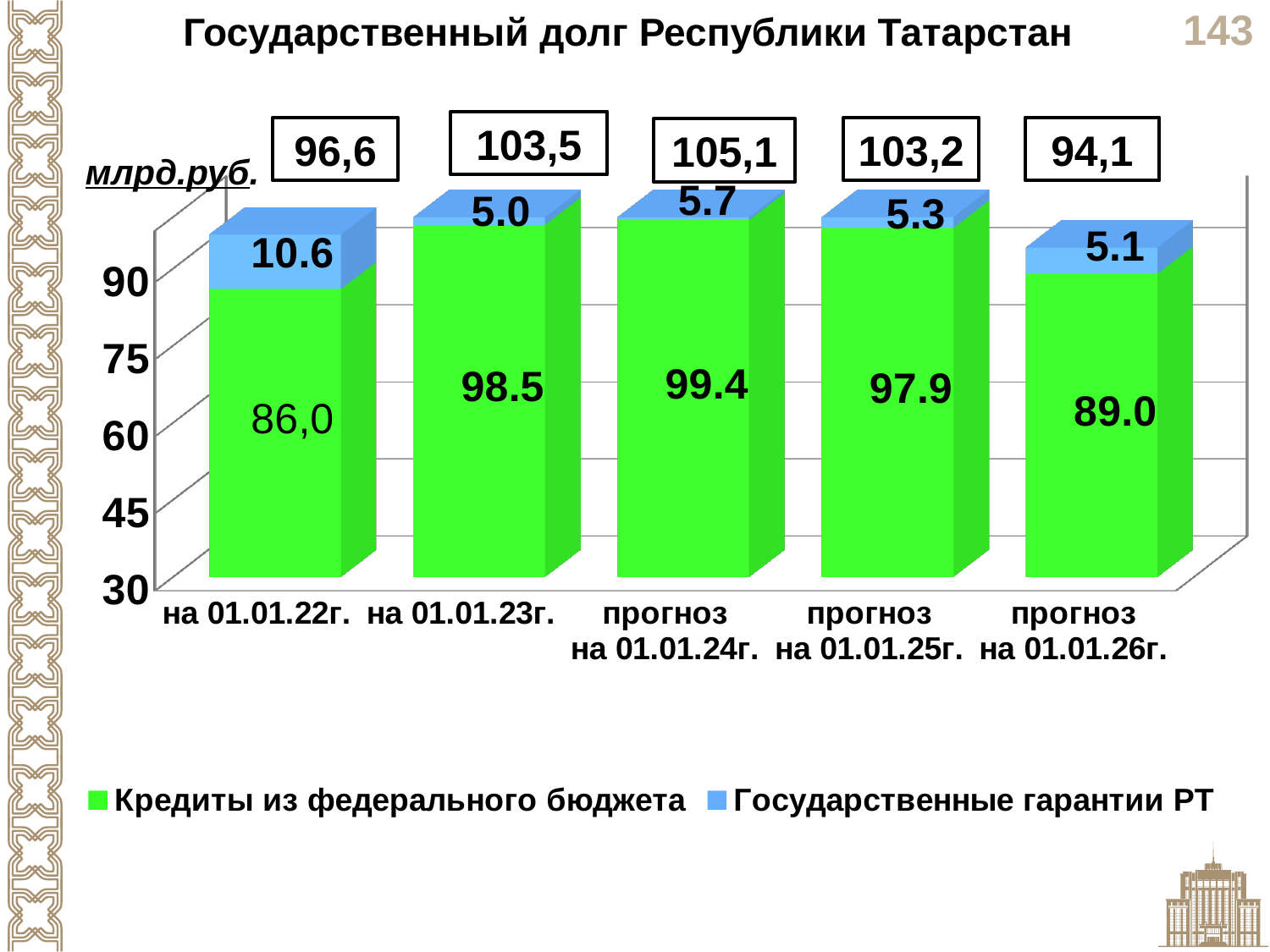
What value is shown for Кредиты из федерального бюджета in the прогноз на 01.01.24г. bar? 99.4 What is the total shown above the bar for прогноз на 01.01.25г.? 103,2 What value is shown for Кредиты из федерального бюджета на 01.01.22г.? 86,0 Which period has the highest total state debt? прогноз на 01.01.24г. Which is larger: Государственные гарантии РТ на 01.01.22г. or прогноз на 01.01.24г.? на 01.01.22г. How many periods are shown on the x axis? 5 How many series does the legend list? 2 Which period has the lowest total state debt? прогноз на 01.01.26г. What kind of chart is shown on the slide? stacked bar chart What value is shown for Государственные гарантии РТ in the прогноз на 01.01.26г. bar? 5.1 What is the difference between the Кредиты из федерального бюджета values на 01.01.23г. and на 01.01.22г.? 12.5 What value is shown for Государственные гарантии РТ на 01.01.22г.? 10.6